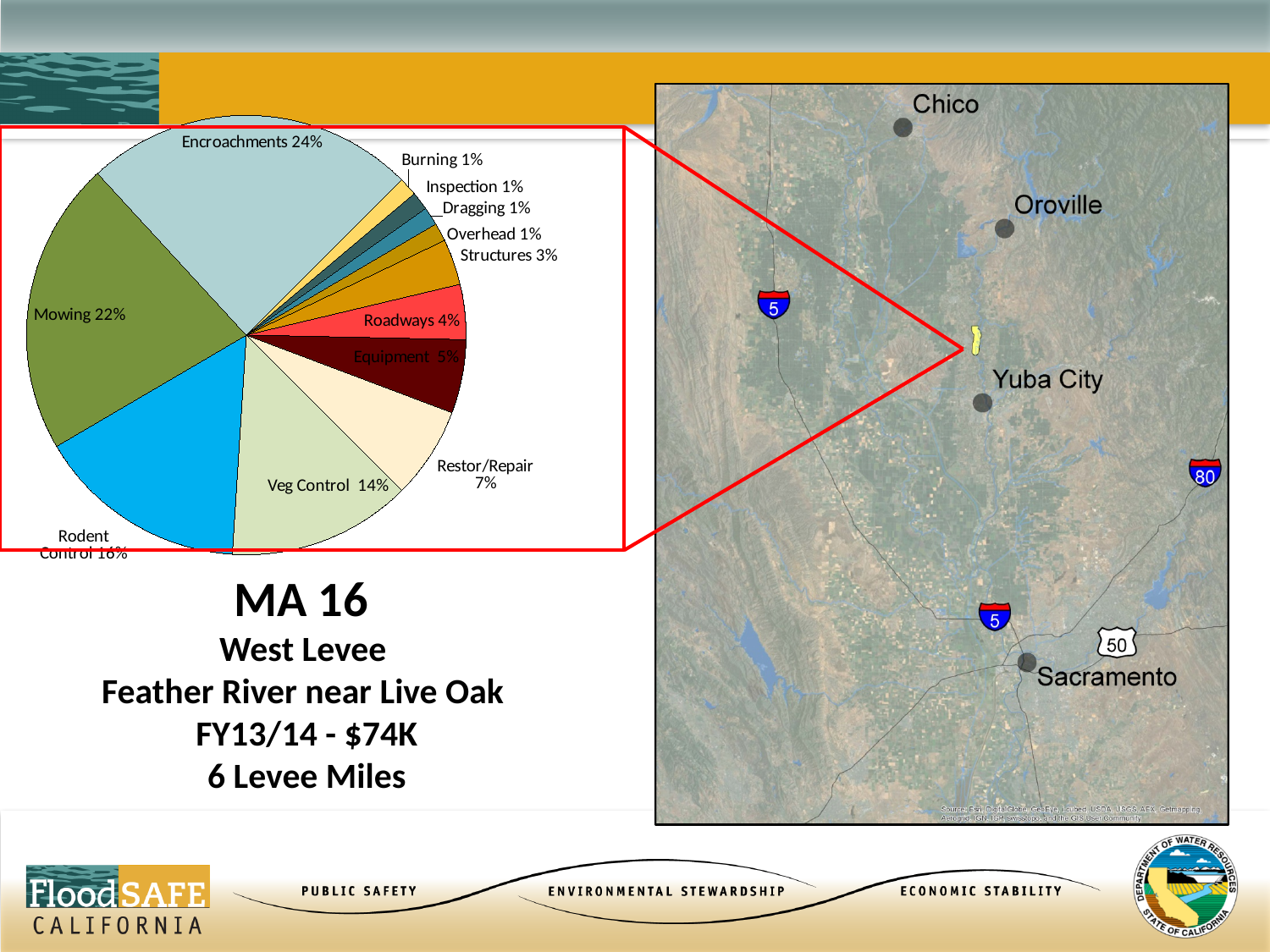
How many categories are shown in the pie chart? 12 What share of the pie does Mowing represent? 22% Which is larger, the share for Mowing or the share for Veg Control? Mowing By how many percentage points does Encroachments exceed Mowing? 2 What share of the pie does Restor/Repair represent? 7% What share of the pie does Structures represent? 3% What share of the pie does Equipment represent? 5% What share of the pie does Roadways represent? 4% Which category has the largest slice of the pie? Encroachments What share of the pie does Encroachments represent? 24% What share of the pie does Veg Control represent? 14% What kind of chart is shown on the slide? pie chart